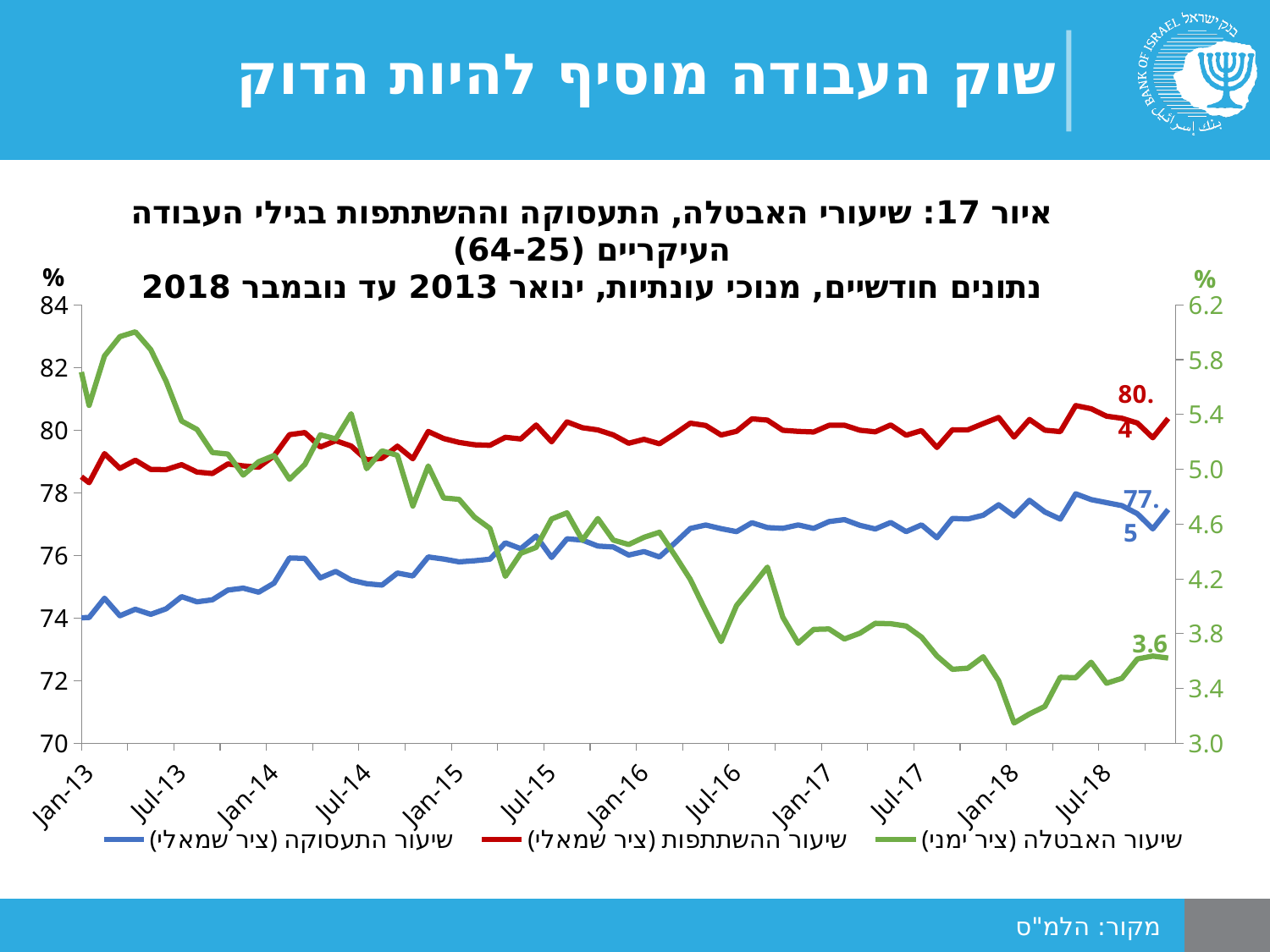
What kind of chart is shown on the slide? Line chart What is the last labelled value of the employment rate series (שיעור התעסוקה, blue line)? 77.5 What is the last labelled value of the participation rate series (שיעור ההשתתפות, red line)? 80.4 How many series does the legend list? 3 Is the unemployment rate (green line) at Jan-18 greater or less than 3.4 on the right axis? less Does the employment rate (blue line) generally rise or fall from Jan-13 to the end of the period? Rise At Jan-13, which is higher: the participation rate (red line) or the employment rate (blue line)? Participation rate (שיעור ההשתתפות) Which series is plotted on the right axis (ציר ימני)? שיעור האבטלה (unemployment rate) Does the unemployment rate (green line) generally rise or fall from Jan-13 to the end of the period? Fall What is the difference between the final labelled participation rate (80.4) and the final labelled employment rate (77.5)? 2.9 What is the last labelled value of the unemployment rate series (שיעור האבטלה, green line)? 3.6 Is the employment rate (blue line) at Jan-13 greater or less than 76 on the left axis? less